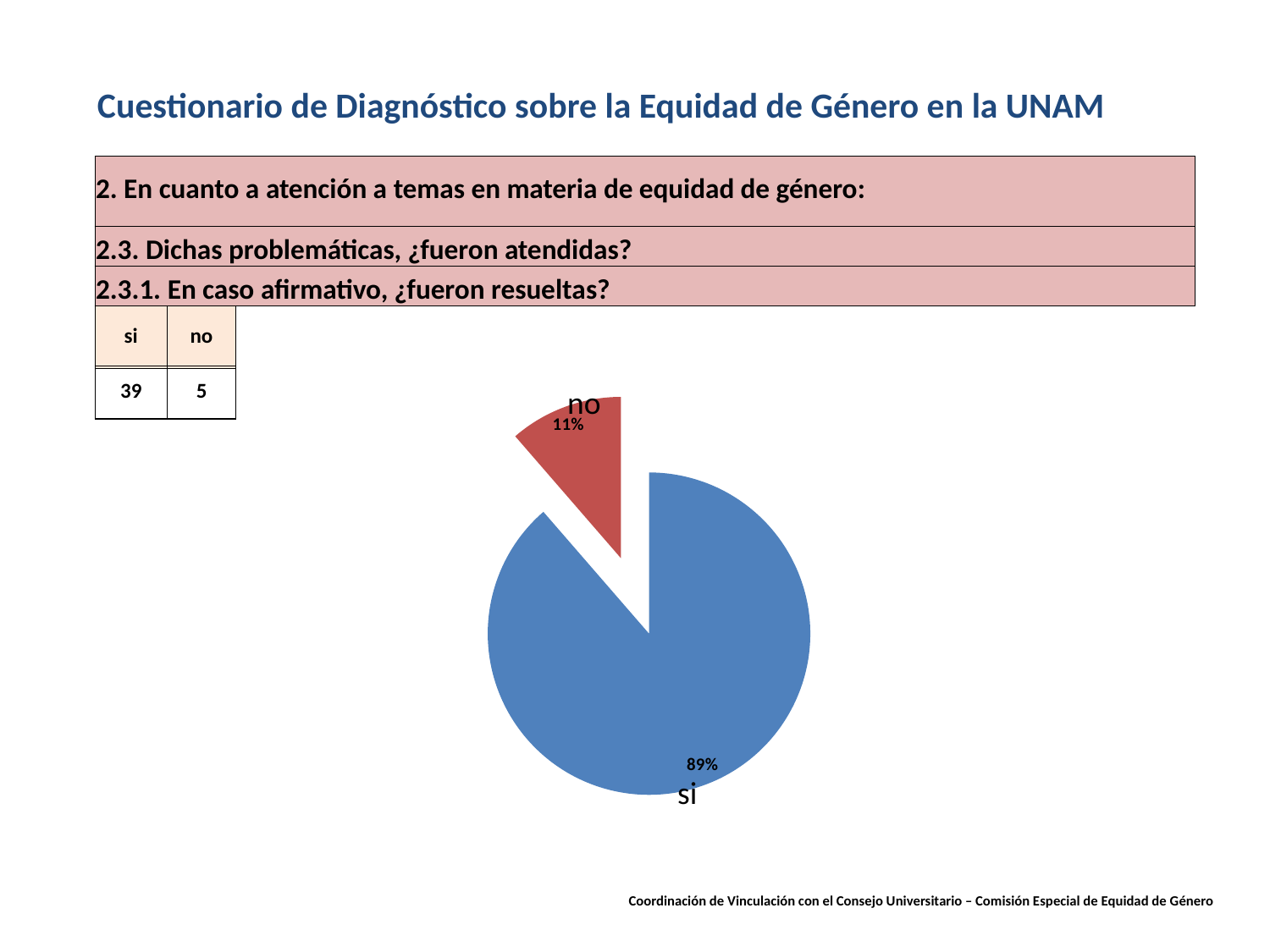
Which is larger, the "si" slice or the "no" slice? si Is the share of the "si" slice greater or less than 50%? greater What percentage of the pie does the "si" slice represent? 89% What is the difference in percentage points between the "si" slice and the "no" slice? 78 Which slice of the pie is the smallest? no What kind of chart is shown on the slide? pie chart How many slices does the pie chart have? 2 What percentage of the pie does the "no" slice represent? 11% What colour is the "no" slice of the pie? red What colour is the "si" slice of the pie? blue Which slice of the pie is the largest? si